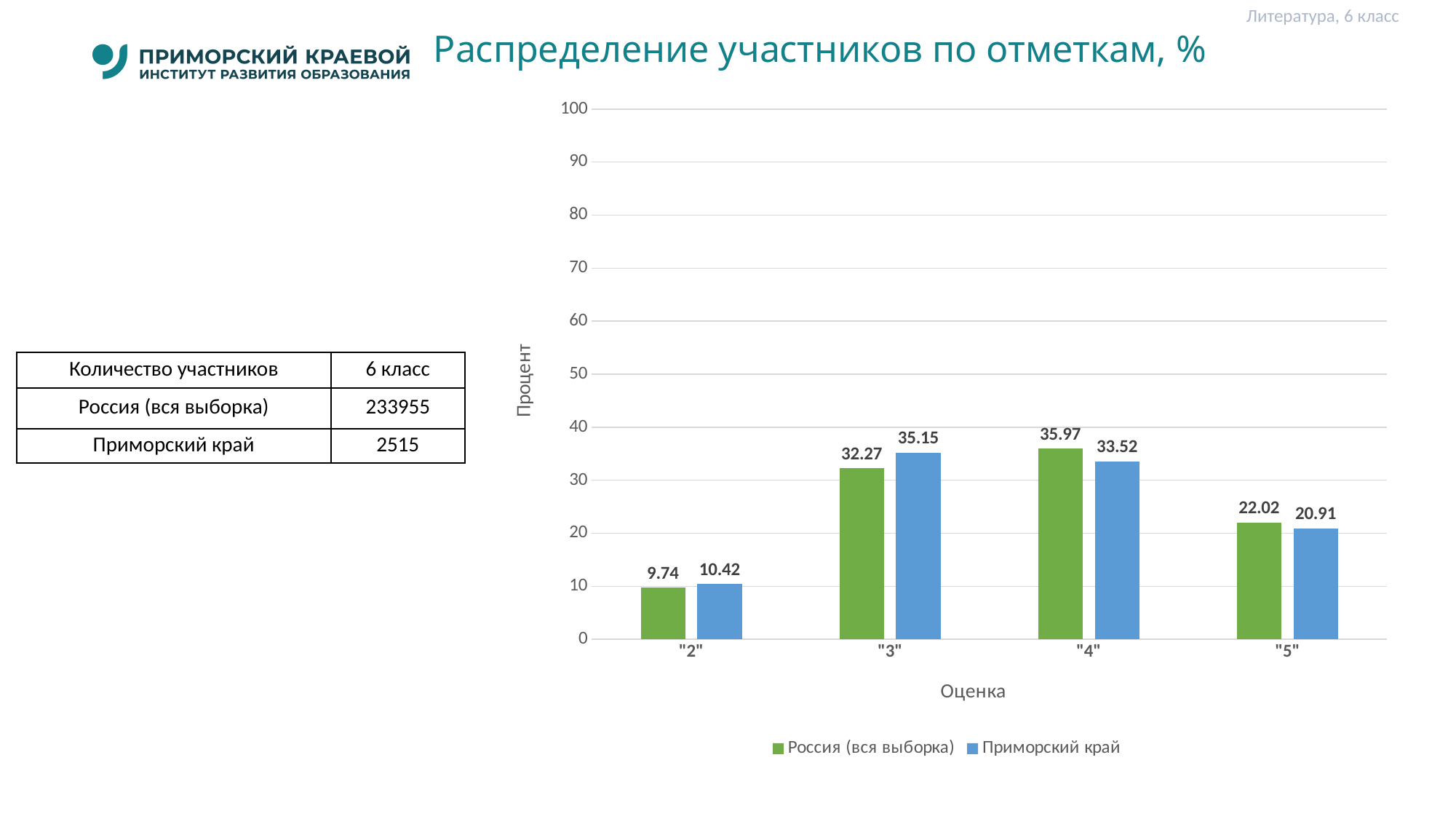
Is the value for Приморский край at grade "3" greater or less than 30? greater What is the label of the y axis? Процент How many grade categories are shown on the x axis? 4 Which grade has the highest value for Россия (вся выборка)? "4" How many series does the legend list? 2 What is the value for Россия (вся выборка) at grade "3"? 32.27 What is the value for Приморский край at grade "2"? 10.42 What kind of chart is shown on the slide? bar chart What is the difference between Россия (вся выборка) and Приморский край at grade "4"? 2.45 What is the value for Приморский край at grade "5"? 20.91 Which grade has the lowest value for Приморский край? "2" At grade "3", which series has the larger value, Россия (вся выборка) or Приморский край? Приморский край